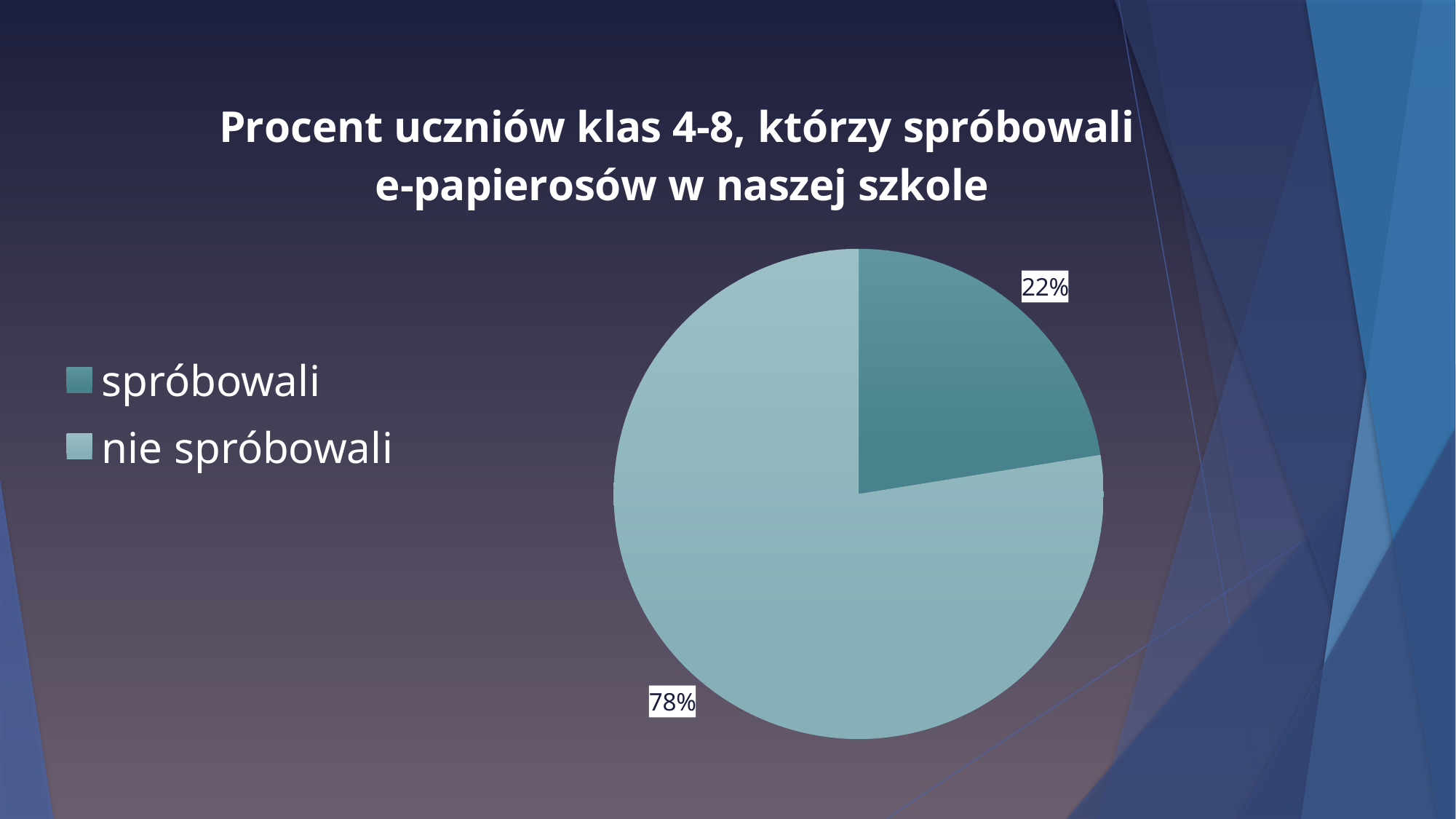
What percentage of students is shown for "spróbowali"? 22% What is the title of the chart? Procent uczniów klas 4-8, którzy spróbowali e-papierosów w naszej szkole Which is larger, the share for "spróbowali" or for "nie spróbowali"? nie spróbowali What kind of chart is shown on the slide? pie chart What is the difference in percentage points between "nie spróbowali" and "spróbowali"? 56 What percentage of students is shown for "nie spróbowali"? 78% Which category has the smallest share of the pie? spróbowali How many entries does the legend list? 2 Which category has the largest share of the pie? nie spróbowali Which legend entry is shown with the darker teal colour? spróbowali How many slices does the pie chart have? 2 What share of the pie does the "spróbowali" slice represent? 22%